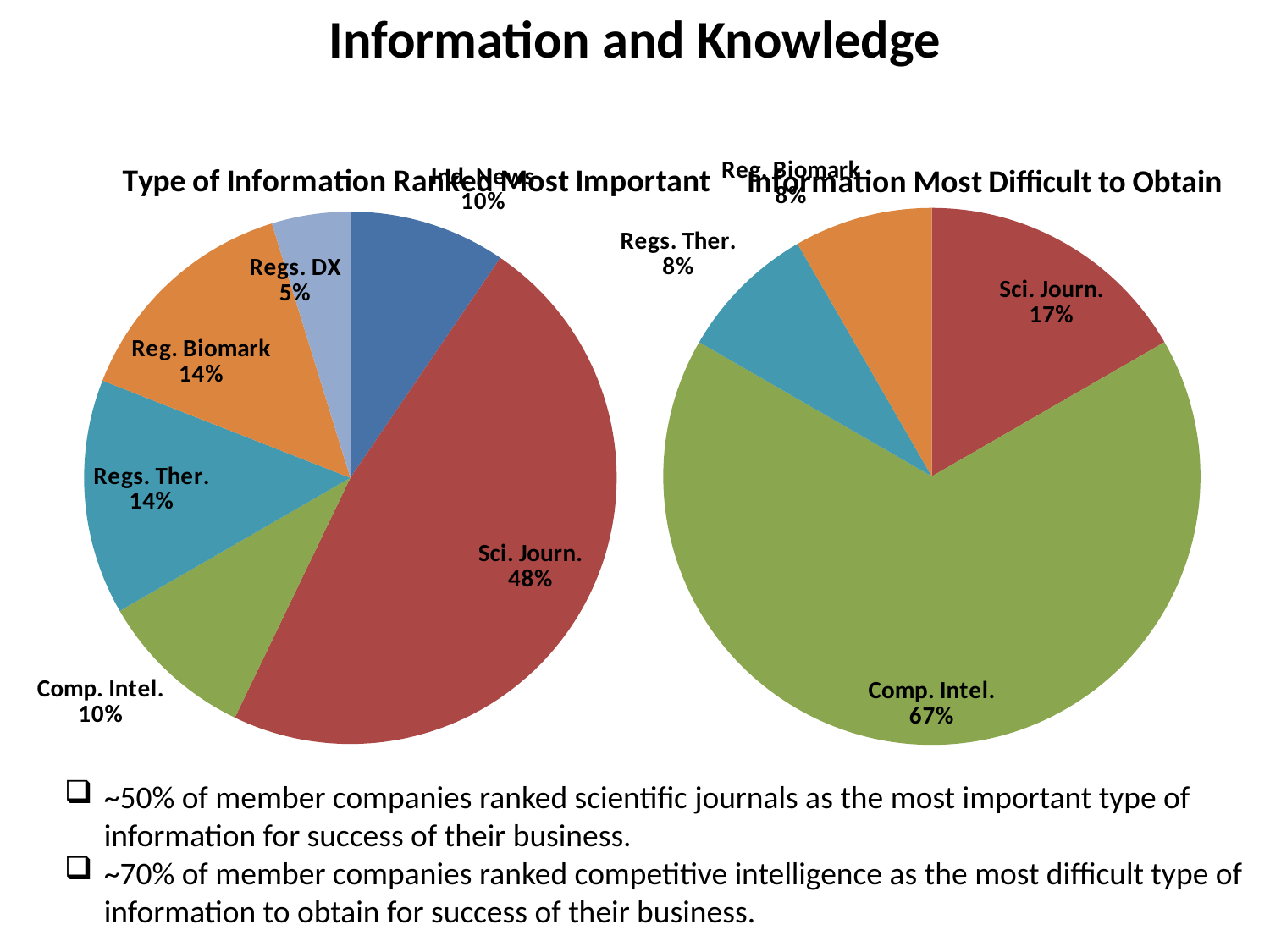
In the 'Type of Information Ranked Most Important' chart, what is the difference between the Sci. Journ. share and the Comp. Intel. share? 38% In the 'Type of Information Ranked Most Important' chart, which category has the smallest share? Regs. DX In the 'Information Most Difficult to Obtain' chart, which is larger, Sci. Journ. or Regs. Ther.? Sci. Journ. In the 'Information Most Difficult to Obtain' chart, what share does Sci. Journ. have? 17% In the 'Type of Information Ranked Most Important' chart, how many slices does the pie have? 6 In the 'Information Most Difficult to Obtain' chart, how many slices does the pie have? 4 In the 'Type of Information Ranked Most Important' chart, what share does Sci. Journ. have? 48% In the 'Information Most Difficult to Obtain' chart, what share does Comp. Intel. have? 67% What type of chart is the 'Information Most Difficult to Obtain' chart? Pie chart In the 'Information Most Difficult to Obtain' chart, which category has the largest share? Comp. Intel. In the 'Type of Information Ranked Most Important' chart, what share does Regs. DX have? 5% In the 'Type of Information Ranked Most Important' chart, which category has the largest share? Sci. Journ.